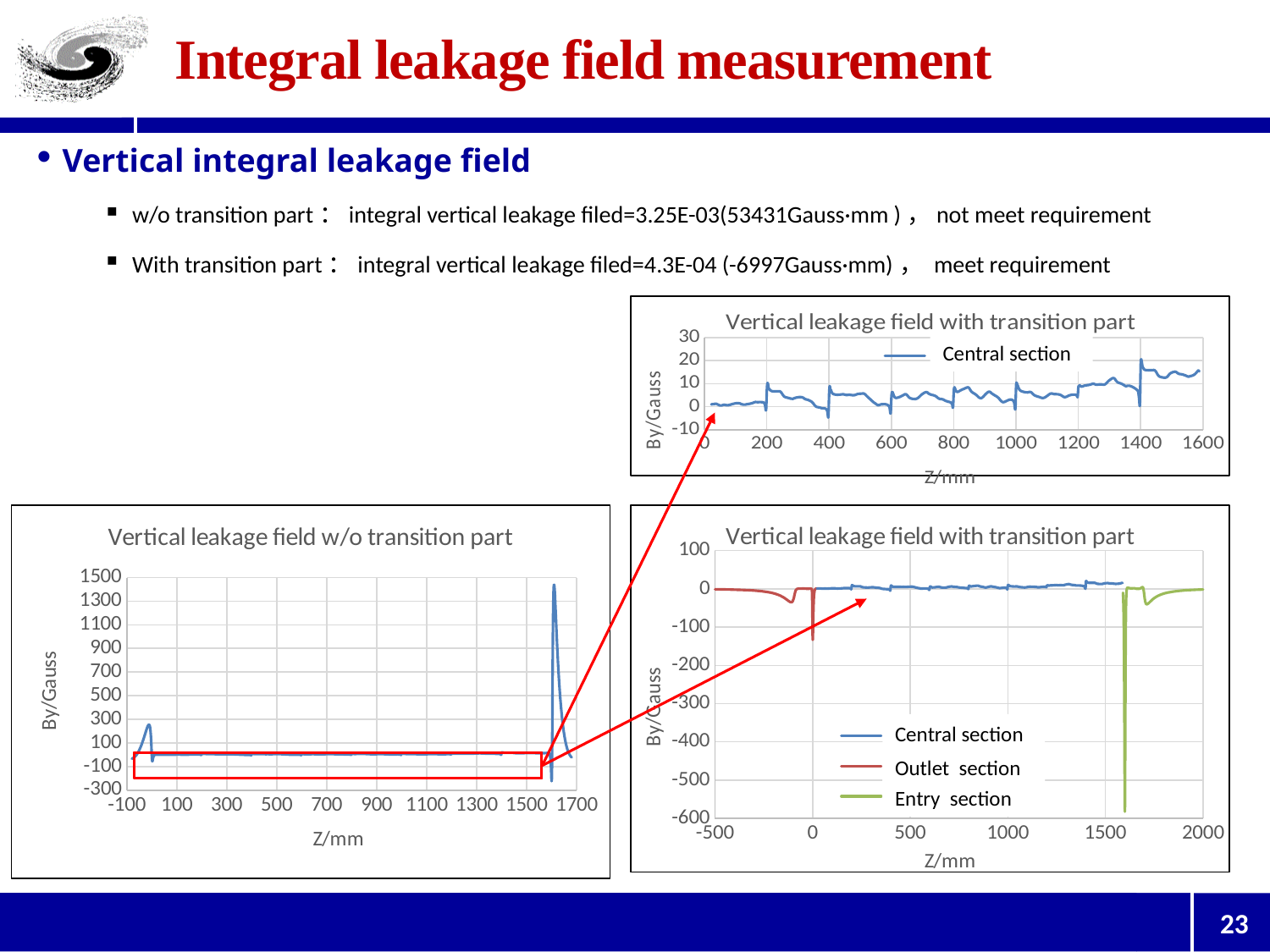
In the bottom-right chart titled 'Vertical leakage field with transition part', which series reaches the lowest value? Entry section In the bottom-left chart titled 'Vertical leakage field w/o transition part', is the small peak near Z=0 greater or less than 100? greater How many series does the legend list in the bottom-right chart titled 'Vertical leakage field with transition part'? 3 What are the legend entries in the bottom-right chart titled 'Vertical leakage field with transition part'? Central section, Outlet section, Entry section What kind of chart is the bottom-left chart titled 'Vertical leakage field w/o transition part'? line chart In the bottom-left chart titled 'Vertical leakage field w/o transition part', is the highest peak of the line (near Z=1600) greater or less than 1300? greater In the bottom-right chart titled 'Vertical leakage field with transition part', is the lowest value of the Entry section greater or less than -500? less How many series does the legend list in the top-right chart titled 'Vertical leakage field with transition part'? 1 What is the y-axis label of the bottom-left chart titled 'Vertical leakage field w/o transition part'? By/Gauss In the bottom-right chart titled 'Vertical leakage field with transition part', which series has a lower minimum, Outlet section or Entry section? Entry section